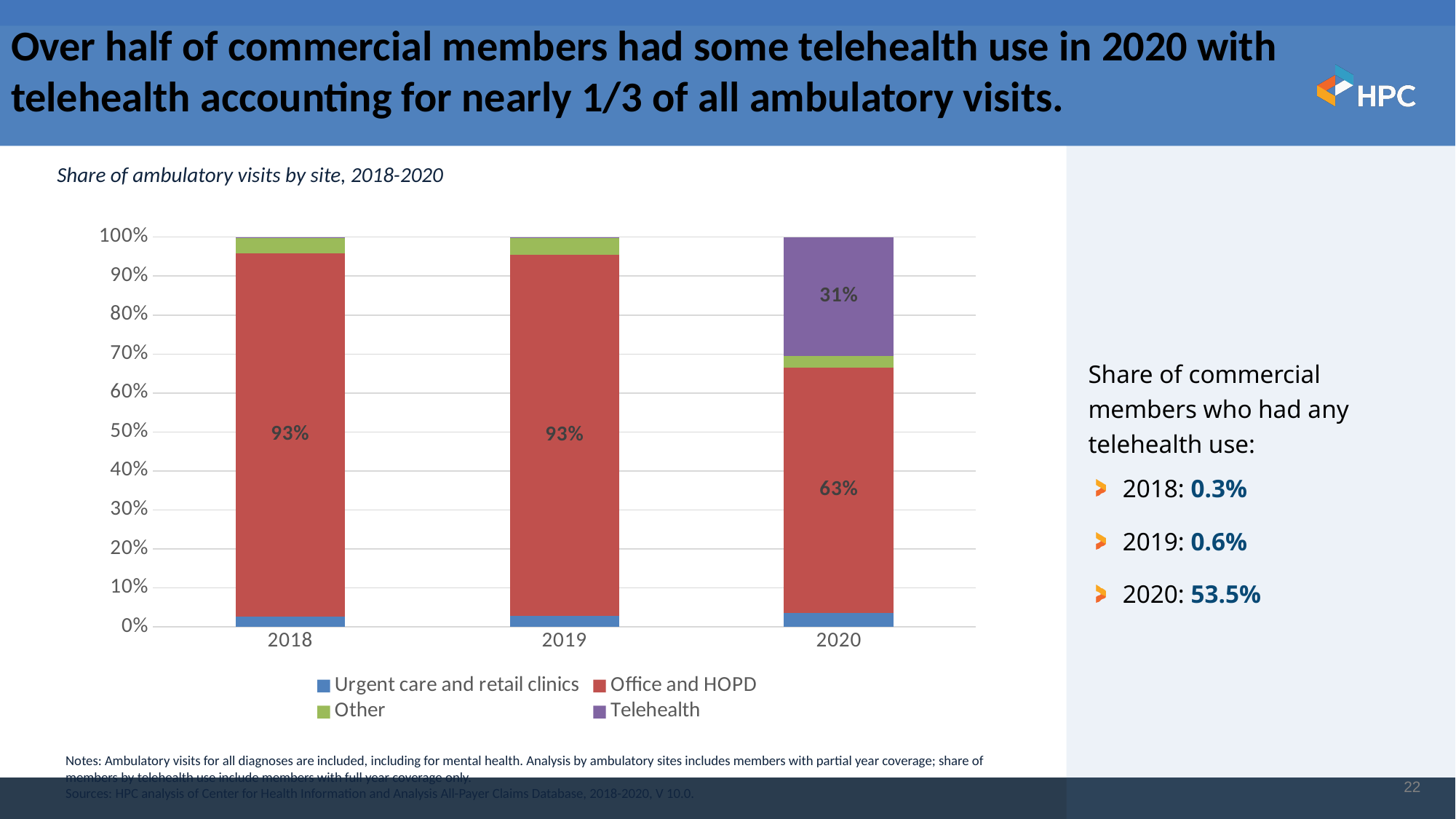
Does the Office and HOPD share rise or fall from 2019 to 2020? Fall What kind of chart is shown on the slide? Stacked bar chart What share of ambulatory visits was Office and HOPD in 2019? 93% By how many percentage points did the Office and HOPD share fall from 2019 to 2020? 30 percentage points Is the Urgent care and retail clinics share in 2018 greater or less than 10%? less How many series does the chart legend list? 4 How many years are shown on the x axis of the chart? 3 What share of ambulatory visits was Telehealth in 2020? 31% What share of ambulatory visits was Office and HOPD in 2020? 63% What share of ambulatory visits was Office and HOPD in 2018? 93% What is the title of the chart? Share of ambulatory visits by site, 2018-2020 In 2020, which was larger: the Office and HOPD share or the Telehealth share? Office and HOPD